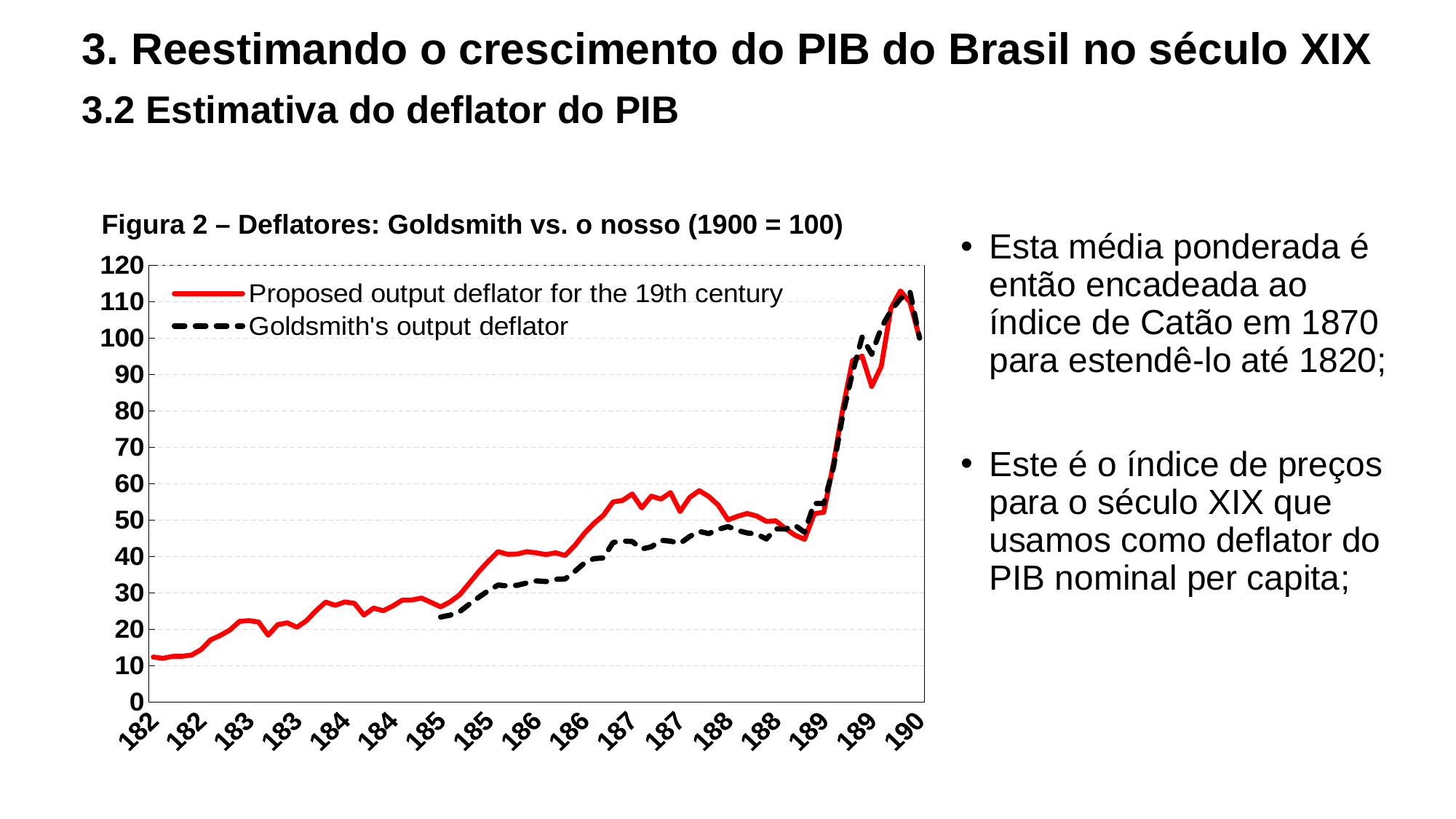
What kind of chart is shown in Figura 2? line chart At the right end of the chart, is the value of Goldsmith's output deflator greater or less than 90? greater Overall, do the values of the proposed output deflator rise or fall from the left to the right of the chart? rise At its highest peak, is the proposed output deflator for the 19th century greater or less than 100? greater What is the highest value shown on the y axis of Figura 2? 120 At the left end of the chart, is the value of the proposed output deflator for the 19th century greater or less than 20? less What is the title of the chart on the slide? Figura 2 – Deflatores: Goldsmith vs. o nosso (1900 = 100) How many series does the legend of Figura 2 list? 2 Which series in Figura 2 starts further to the left on the x axis? Proposed output deflator for the 19th century Which series in Figura 2 is drawn as a black dashed line? Goldsmith's output deflator